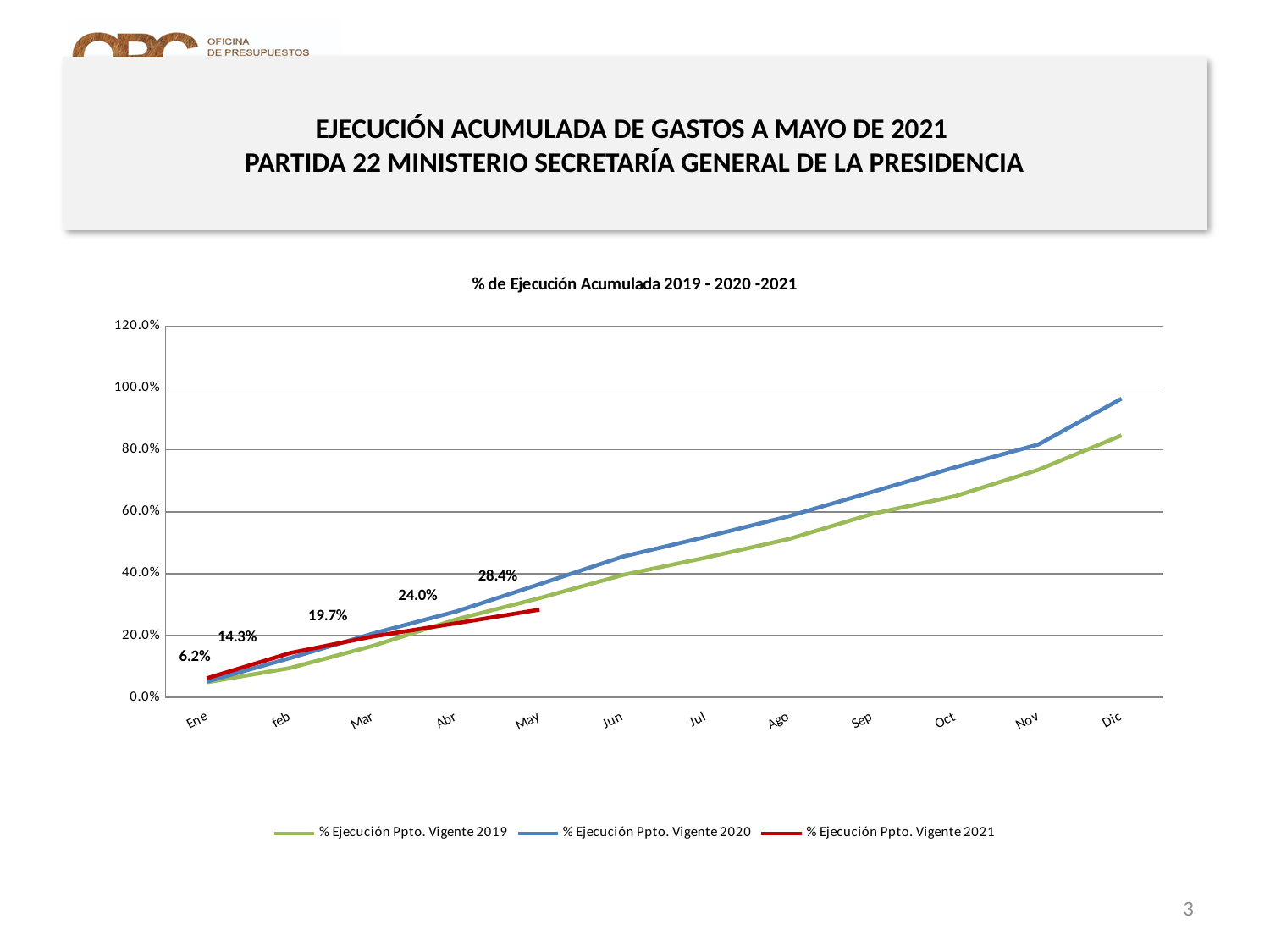
How many series does the legend list? 3 How many months are shown on the x axis? 12 In Dic, which series is higher: % Ejecución Ppto. Vigente 2019 or % Ejecución Ppto. Vigente 2020? % Ejecución Ppto. Vigente 2020 What is the value of % Ejecución Ppto. Vigente 2021 for Ene? 6.2% Which month has the highest labelled value for % Ejecución Ppto. Vigente 2021? May What is the value of % Ejecución Ppto. Vigente 2021 for Abr? 24.0% What is the value of % Ejecución Ppto. Vigente 2021 for May? 28.4% What is the difference between the 2021 values for May and Ene? 22.2% What kind of chart is shown on the slide? Line chart What is the value of % Ejecución Ppto. Vigente 2021 for Mar? 19.7% Is the value for % Ejecución Ppto. Vigente 2020 in Jun greater or less than 60.0%? less Is the value for % Ejecución Ppto. Vigente 2020 in Dic greater or less than 80.0%? greater